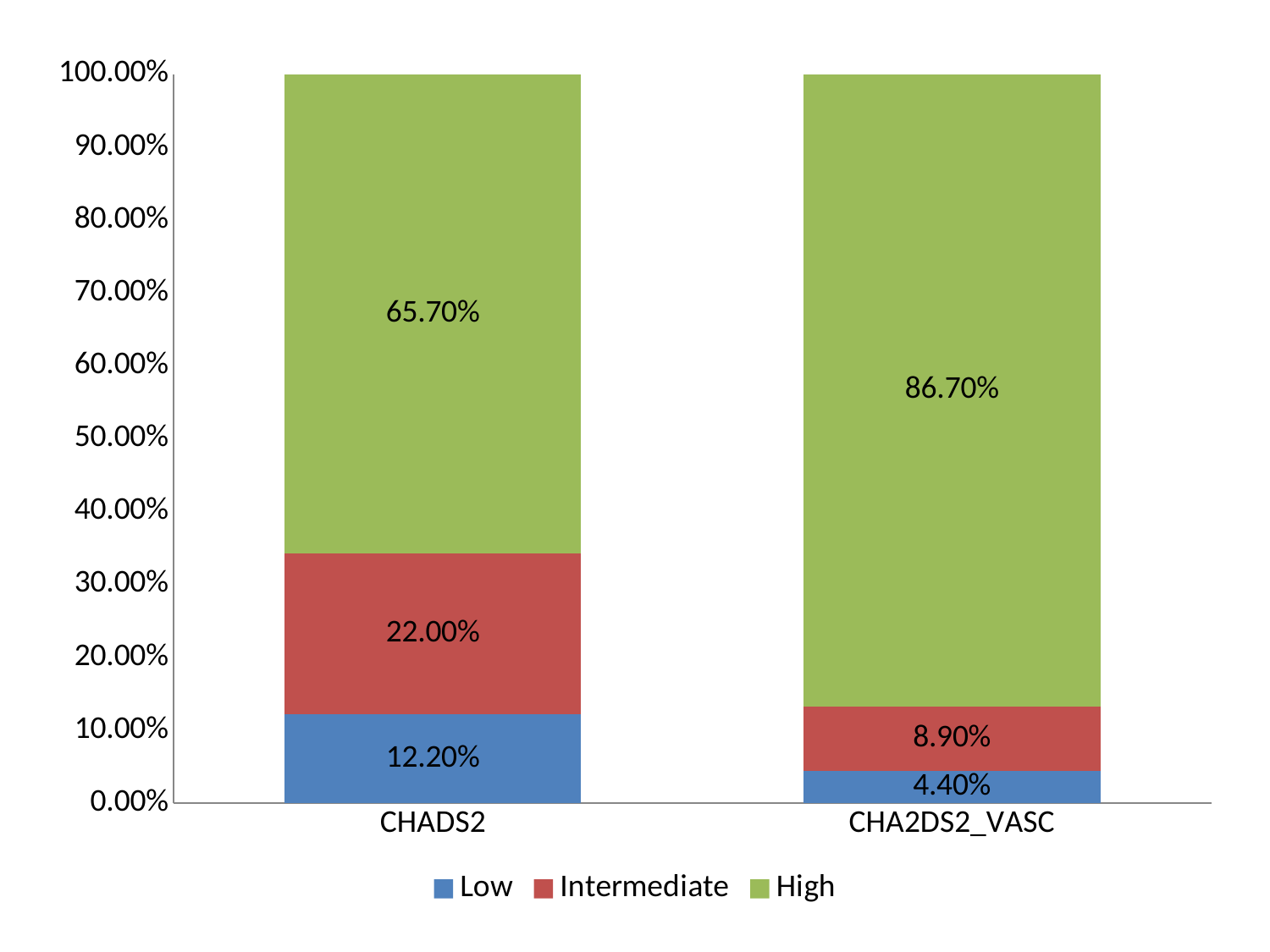
What is the difference between the Intermediate values for CHADS2 and CHA2DS2_VASC? 13.10% What is the value for High in the CHADS2 bar? 65.70% What is the difference between the High values for CHA2DS2_VASC and CHADS2? 21.00% What is the value for Low in the CHADS2 bar? 12.20% What kind of chart is this? Stacked bar chart What is the total of the CHADS2 stacked bar? 99.90% What is the value for Low in the CHA2DS2_VASC bar? 4.40% What is the value for Intermediate in the CHA2DS2_VASC bar? 8.90% Which category has the lower Intermediate value? CHA2DS2_VASC How many categories are shown on the x axis? 2 Which category has the higher High value, CHADS2 or CHA2DS2_VASC? CHA2DS2_VASC How many series does the legend list? 3